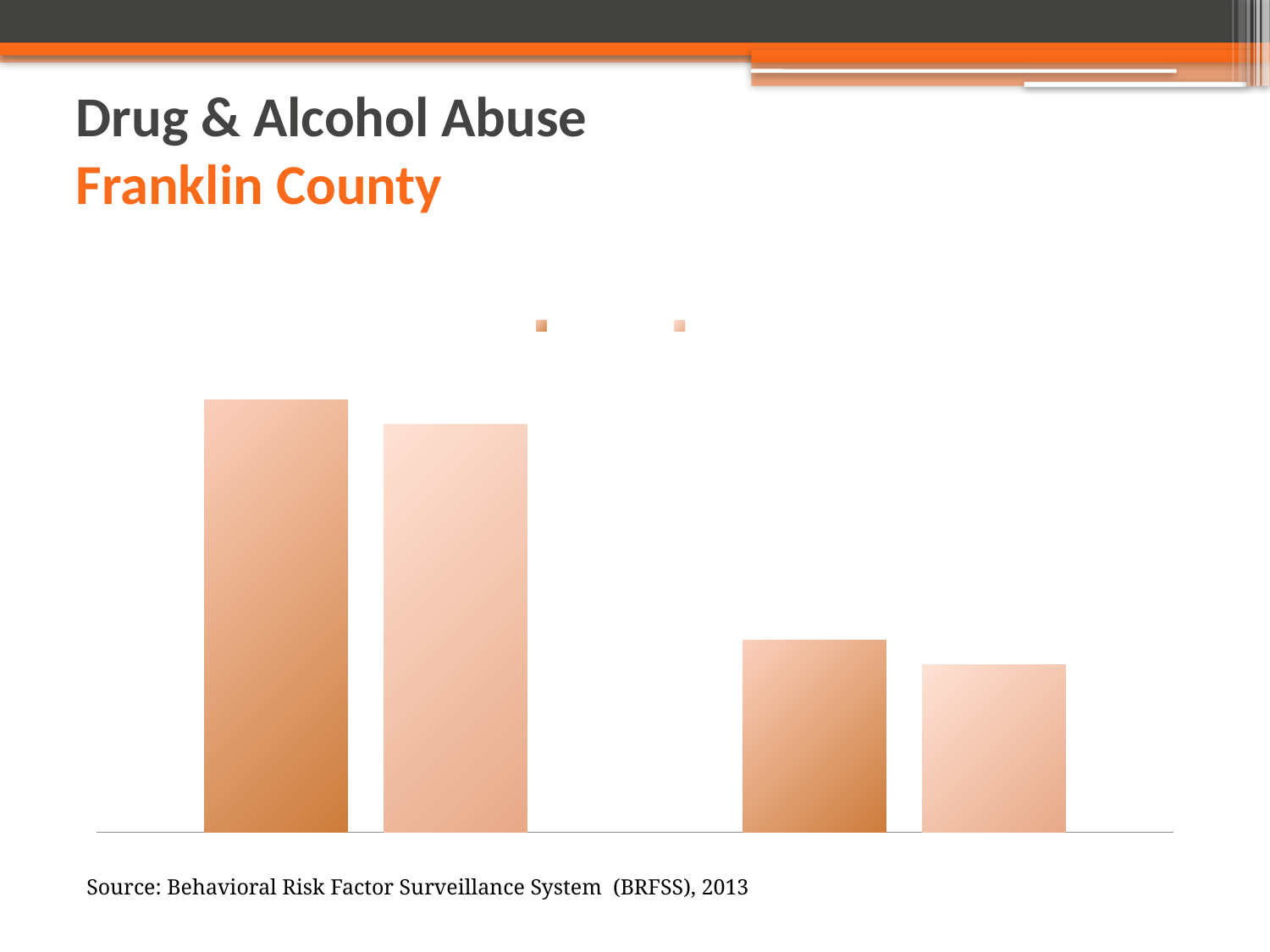
Which county is named in the slide title? Franklin County How many bars are plotted in the chart? 4 Within the right group of bars, which bar is taller, the darker orange bar or the lighter bar? the darker orange bar How many series does the legend list? 2 What kind of chart is shown on the slide? bar chart How many groups of bars are plotted along the x axis? 2 What data source is cited below the chart? Behavioral Risk Factor Surveillance System (BRFSS), 2013 Do the bar heights rise or fall moving from the left group to the right group? fall Within the left group of bars, which bar is taller, the darker orange bar or the lighter bar? the darker orange bar Which group of bars is taller, the left group or the right group? the left group